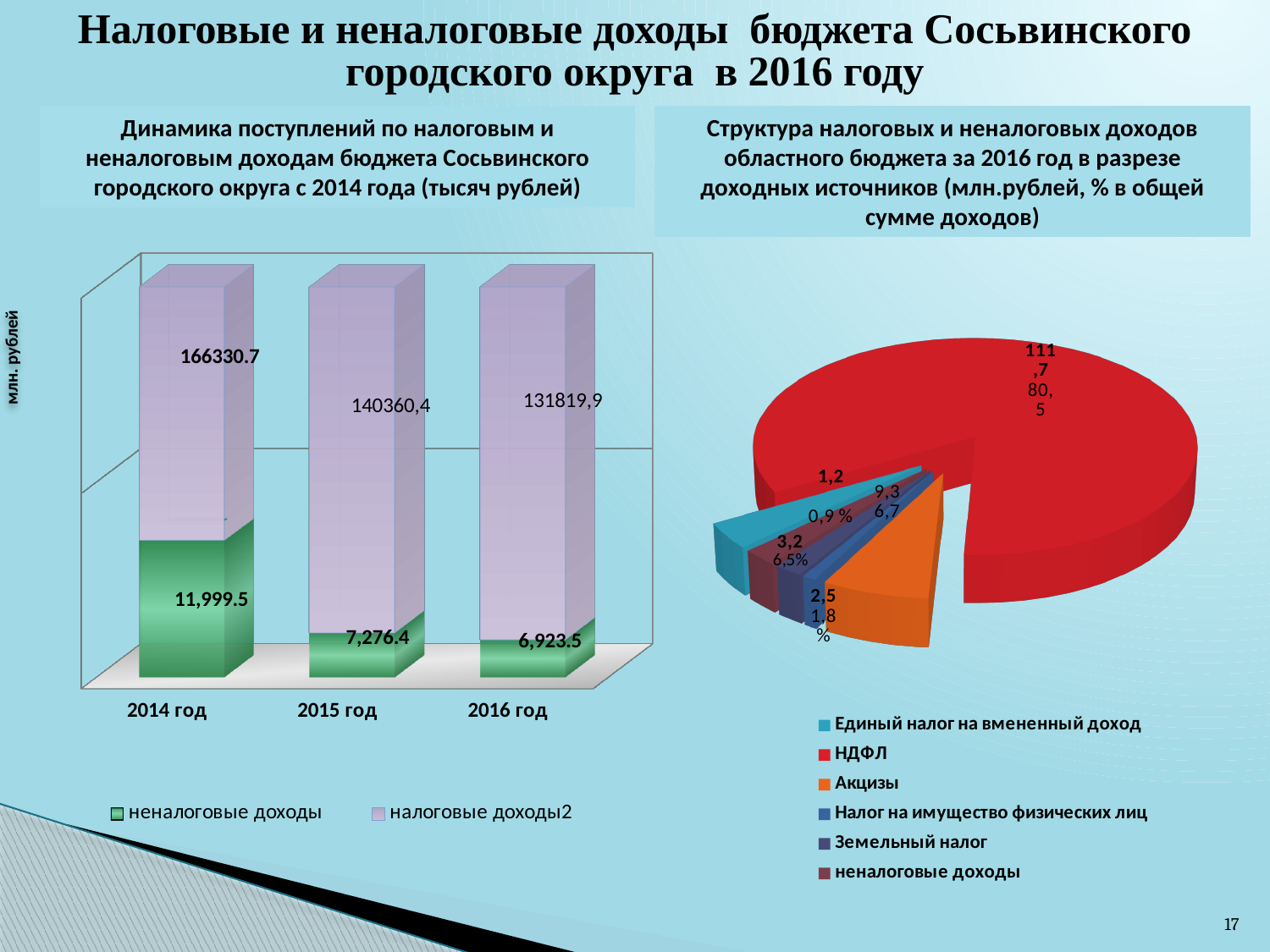
In the left bar chart, what is the value of налоговые доходы2 for 2015 год? 140360,4 In the right pie chart, which income source has the largest slice? НДФЛ In the left bar chart, what is the value of неналоговые доходы for 2016 год? 6,923.5 How many entries does the legend of the right pie chart list? 6 In the left bar chart, what is the difference between налоговые доходы2 in 2015 год and 2016 год? 8540,5 What kind of chart is the right chart, 'Структура налоговых и неналоговых доходов'? pie chart In the left bar chart, what is the value of налоговые доходы2 for 2014 год? 166330.7 In the left bar chart, do the values for налоговые доходы2 rise or fall from 2014 год to 2016 год? fall What kind of chart is the left chart, 'Динамика поступлений по налоговым и неналоговым доходам'? bar chart How many years (categories) are shown in the left bar chart? 3 In the left bar chart, which year has the highest value for неналоговые доходы? 2014 год How many series does the legend of the left bar chart list? 2